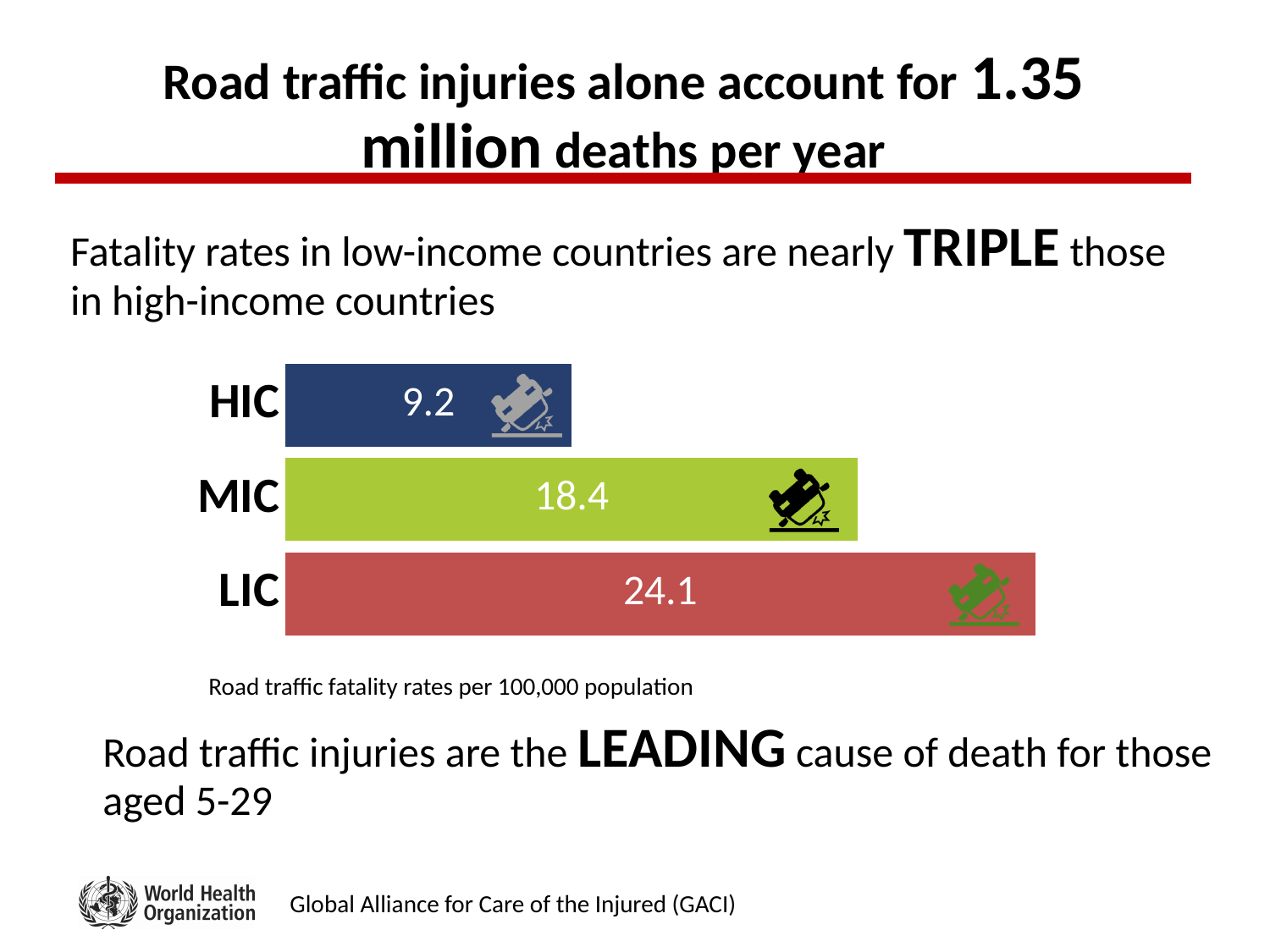
What is the difference between the fatality rates for MIC and HIC? 9.2 What is the difference between the fatality rates for LIC and HIC? 14.9 What colour is the bar for LIC? Red Which category has the highest fatality rate? LIC What is the road traffic fatality rate for HIC? 9.2 What is the road traffic fatality rate for MIC? 18.4 Which category has the lowest fatality rate? HIC What unit are the fatality rates in the chart expressed in? Per 100,000 population What kind of chart is shown on the slide? Bar chart What is the road traffic fatality rate for LIC? 24.1 How many categories are shown in the chart? 3 Which has a higher fatality rate, MIC or LIC? LIC